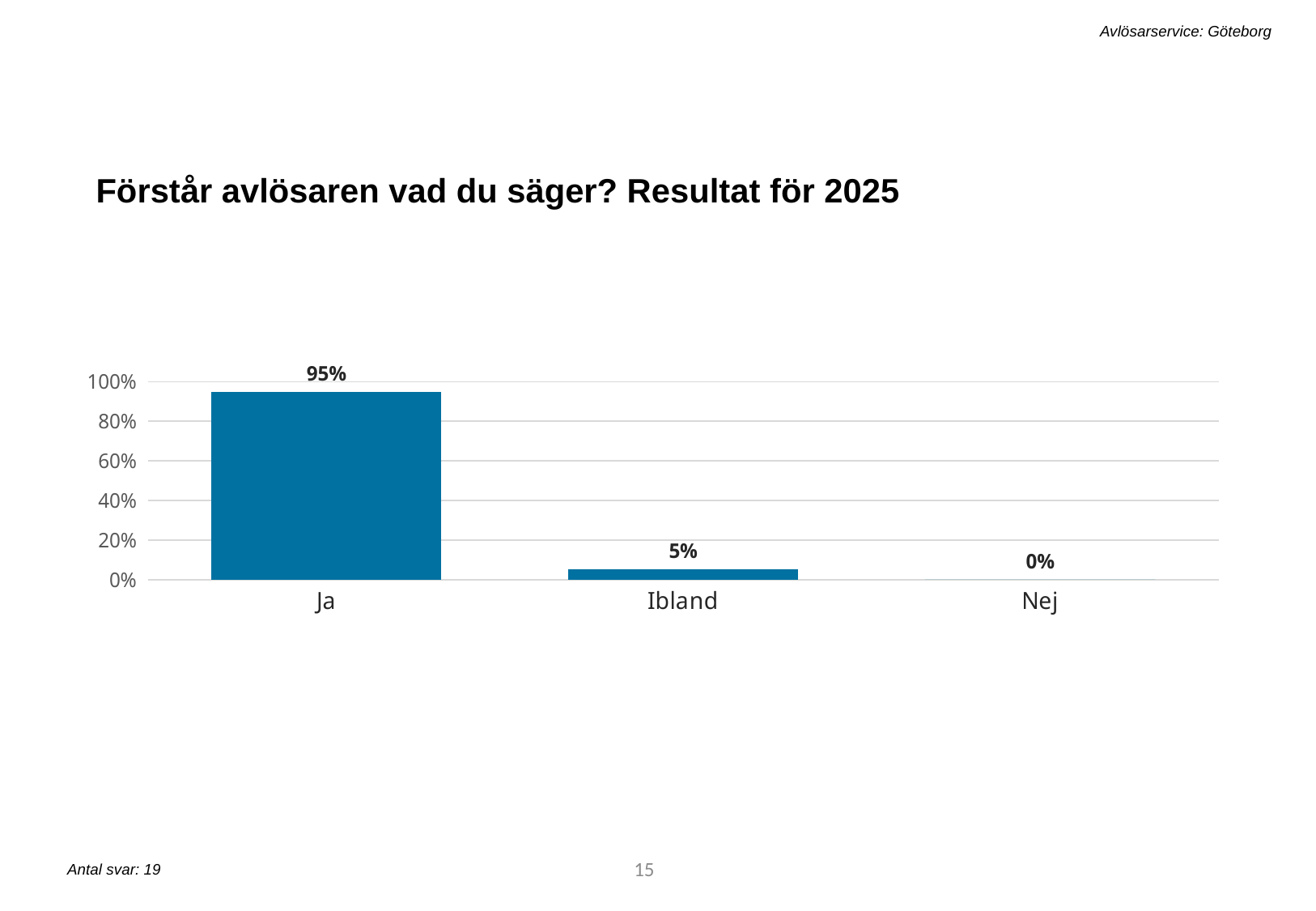
What is the value for Ibland? 5% What kind of chart is shown on the slide? bar chart Which is larger, the value for Ibland or the value for Nej? Ibland How many categories are shown on the x axis? 3 Which category has the highest value? Ja Do the values rise or fall from left to right along the x axis? fall What is the difference between the values for Ja and Ibland? 90% What is the value for Nej? 0% What is the title of the chart? Förstår avlösaren vad du säger? Resultat för 2025 What is the value for Ja? 95% Is the value for Ja greater or less than 80%? greater Which category has the lowest value? Nej